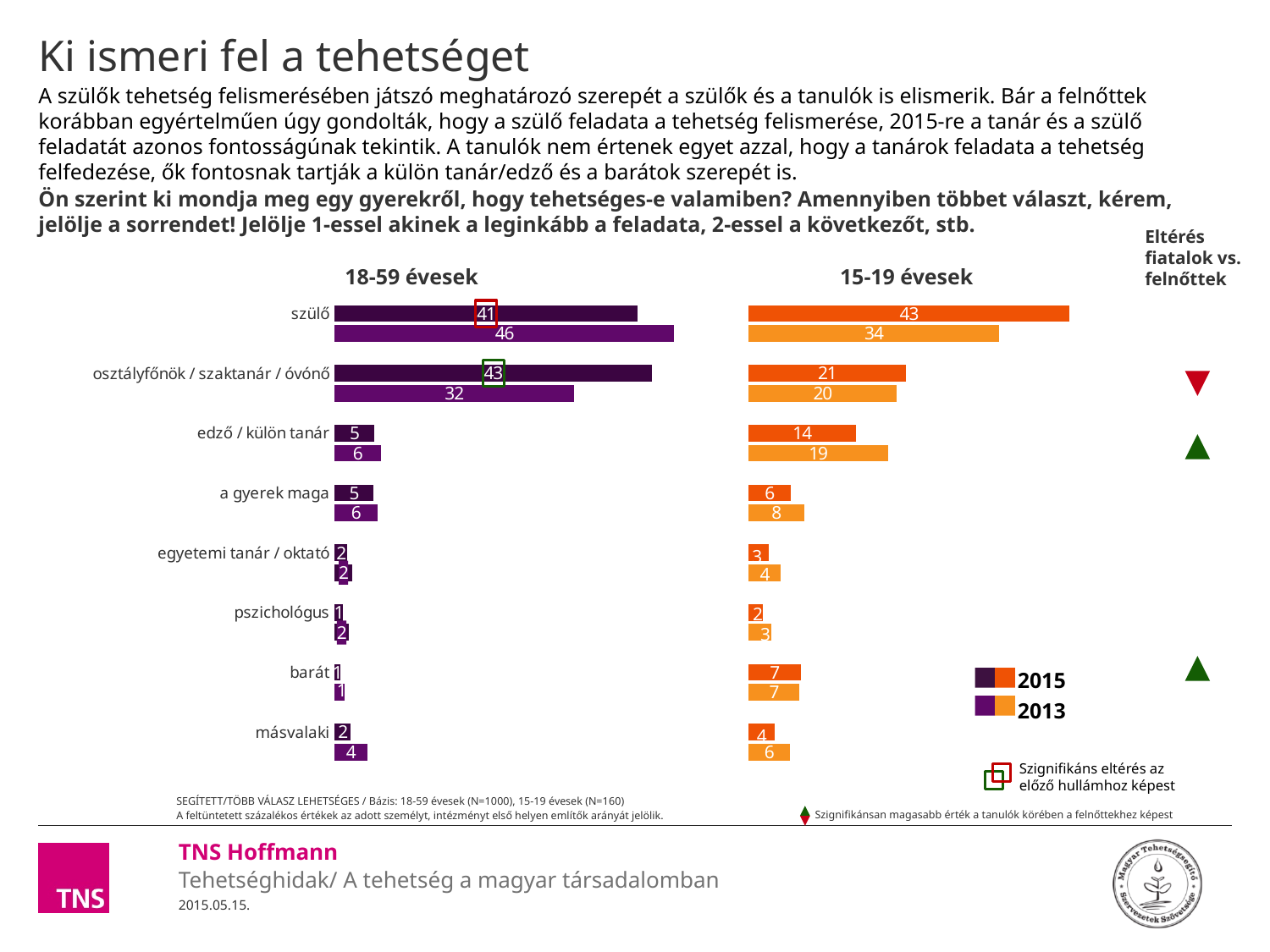
In the 18-59 évesek chart, which category has the highest 2015 value? osztályfőnök / szaktanár / óvónő What type of chart is the 15-19 évesek chart? bar chart In the 15-19 évesek chart, which category has the highest 2013 value? szülő How many series does the legend list? 2 In the 15-19 évesek chart, what is the 2013 value for edző / külön tanár? 19 How many categories are shown in the 18-59 évesek chart? 8 In the 15-19 évesek chart, what is the difference between the 2015 and 2013 values for szülő? 9 In the 15-19 évesek chart, which is larger for edző / külön tanár: the 2015 value or the 2013 value? 2013 In the 18-59 évesek chart, what is the difference between the 2013 and 2015 values for szülő? 5 In the 18-59 évesek chart, what is the 2013 value for osztályfőnök / szaktanár / óvónő? 32 In the 15-19 évesek chart, what is the 2015 value for barát? 7 In the 18-59 évesek chart, what is the 2015 value for szülő? 41